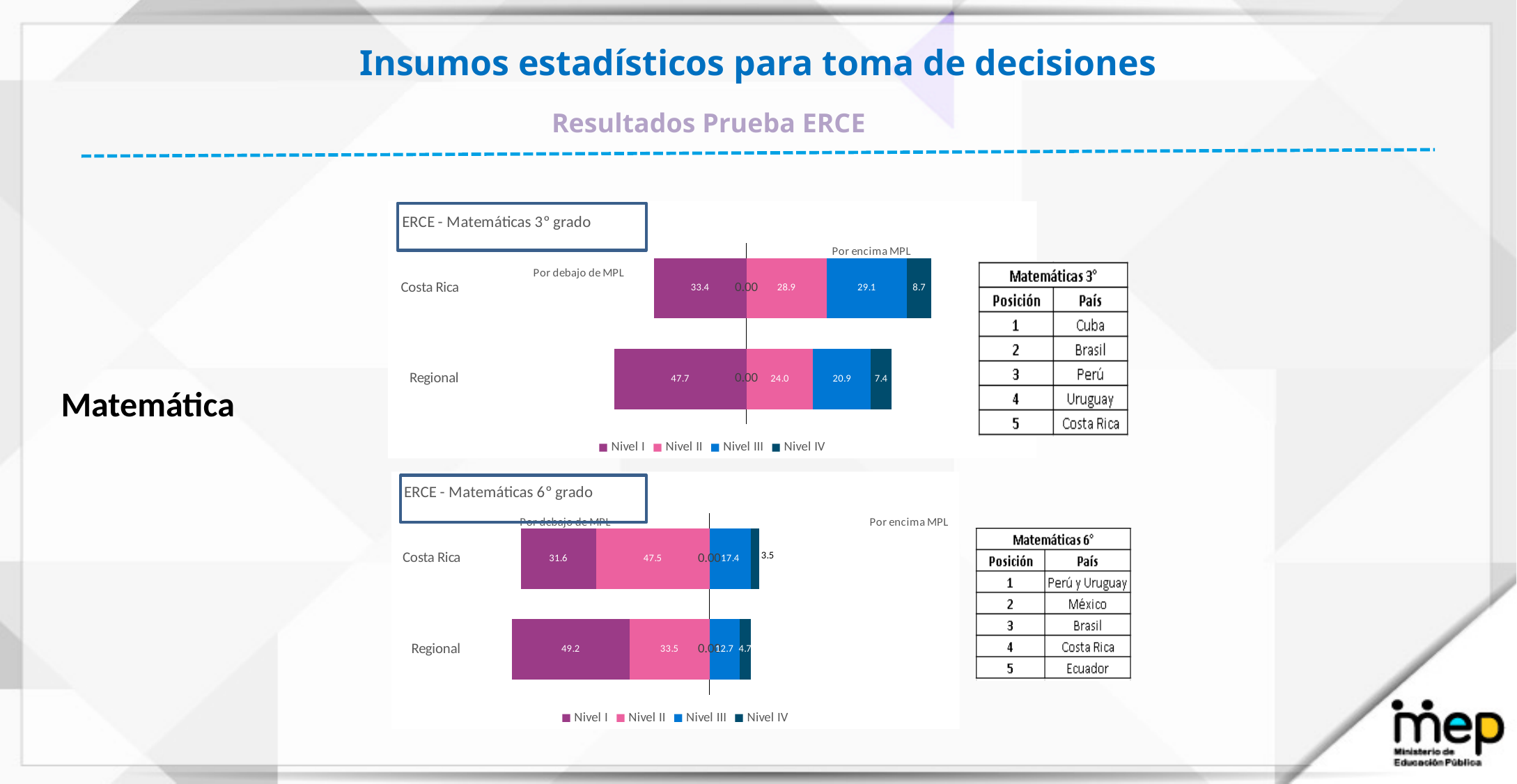
In the ERCE - Matemáticas 6° grado chart, what is the Nivel II value for Costa Rica? 47.5 In the ERCE - Matemáticas 6° grado chart, which has the larger Nivel I value, Costa Rica or Regional? Regional In the ERCE - Matemáticas 3° grado chart, what is the Nivel IV value for Regional? 7.4 In the ERCE - Matemáticas 3° grado chart, what is the total of the Regional stacked bar? 100.0 How many series does the legend of the ERCE - Matemáticas 6° grado chart list? 4 In the ERCE - Matemáticas 3° grado chart, what is the Nivel I value for Costa Rica? 33.4 What kind of chart is the ERCE - Matemáticas 6° grado chart? Stacked bar chart In the ERCE - Matemáticas 3° grado chart, what is the difference between the Nivel I values for Regional and Costa Rica? 14.3 In the ERCE - Matemáticas 6° grado chart, what is the difference between the Nivel II values for Costa Rica and Regional? 14.0 How many categories are plotted in the ERCE - Matemáticas 3° grado chart? 2 In the ERCE - Matemáticas 3° grado chart, which has the larger Nivel III value, Costa Rica or Regional? Costa Rica In the ERCE - Matemáticas 6° grado chart, what is the Nivel III value for Regional? 12.7